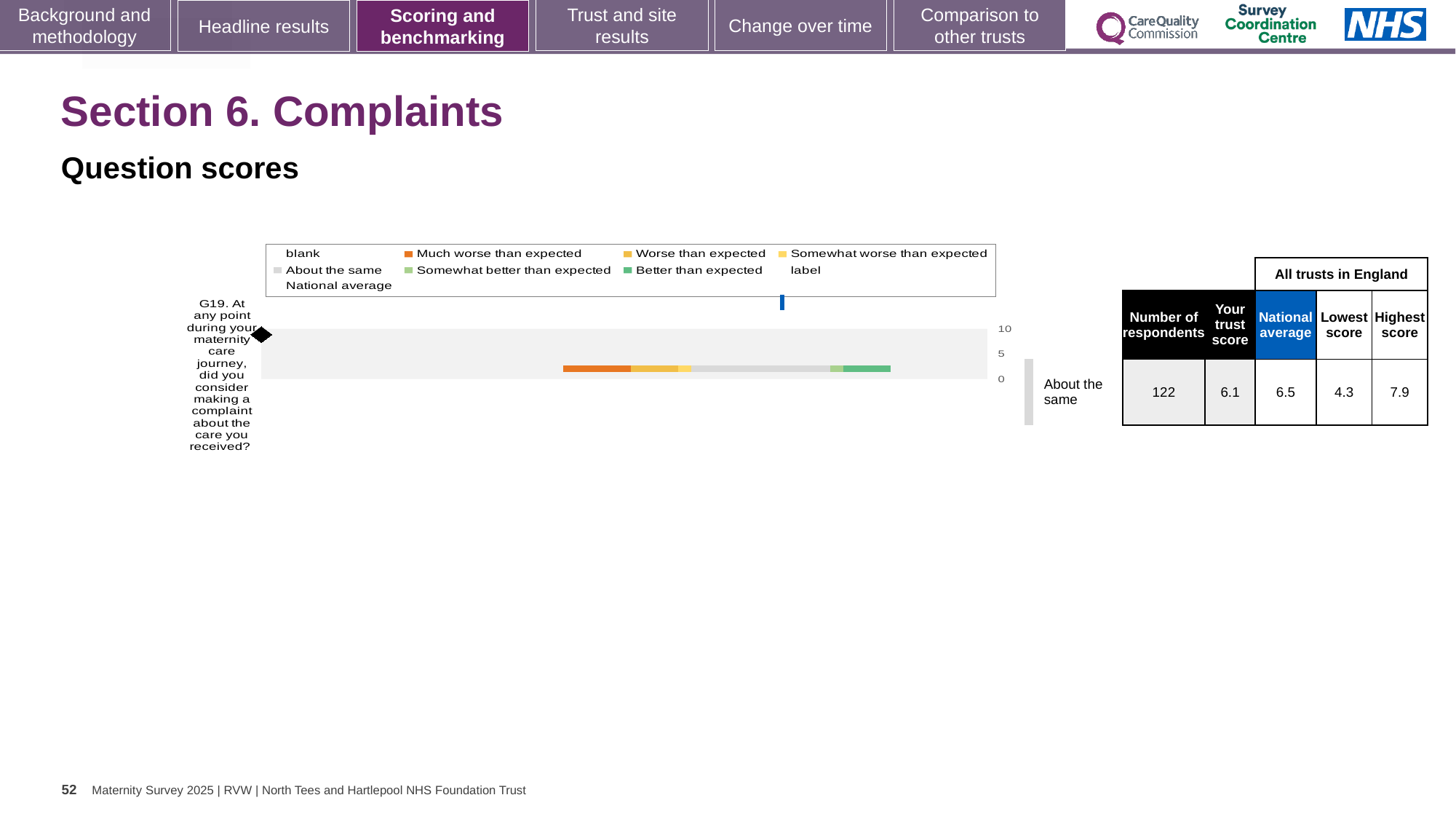
Is the trust score for question G19 greater or less than 5? greater What is the highest score among all trusts in England for question G19? 7.9 What is the trust score for question G19 about considering making a complaint? 6.1 What is the difference between the national average and the trust score for question G19? 0.4 What kind of chart is shown on the slide? bar chart What is the lowest score among all trusts in England for question G19? 4.3 What is the national average score for question G19? 6.5 How many respondents answered question G19? 122 How many questions (categories) are plotted in the chart? 1 What is the difference between the highest and lowest scores among all trusts in England for question G19? 3.6 Which is larger for question G19, the trust score or the national average? national average Which benchmark category is the trust's result for question G19 placed in? About the same